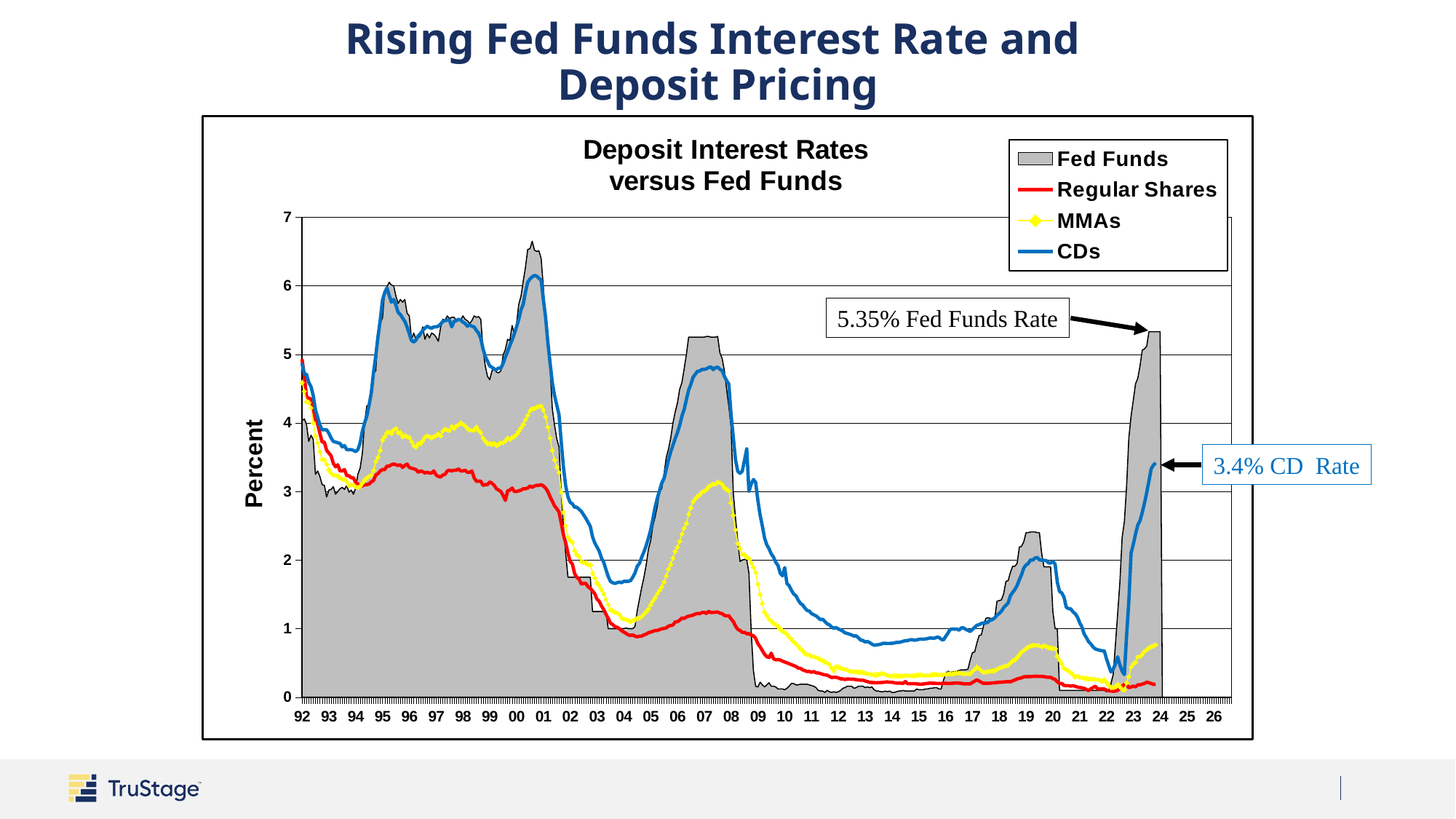
What is the difference between the annotated Fed Funds rate and the annotated CD rate? 1.95% What is the label on the vertical axis of the chart? Percent Is the CDs value in 2007 greater or less than 4? greater Which series is lowest in 2023? Regular Shares Which is larger at the end of the chart, the annotated Fed Funds rate or the annotated CD rate? Fed Funds rate What CD rate is called out by the annotation on the chart? 3.4% Do the CDs values rise or fall from 2022 to 2024? rise Is the Regular Shares value in 2013 greater or less than 1? less How many series does the chart legend list? 4 Is the peak Fed Funds value around 2000-01 greater or less than 6? greater What Fed Funds rate is called out by the annotation on the chart? 5.35% What is the title of the chart? Deposit Interest Rates versus Fed Funds